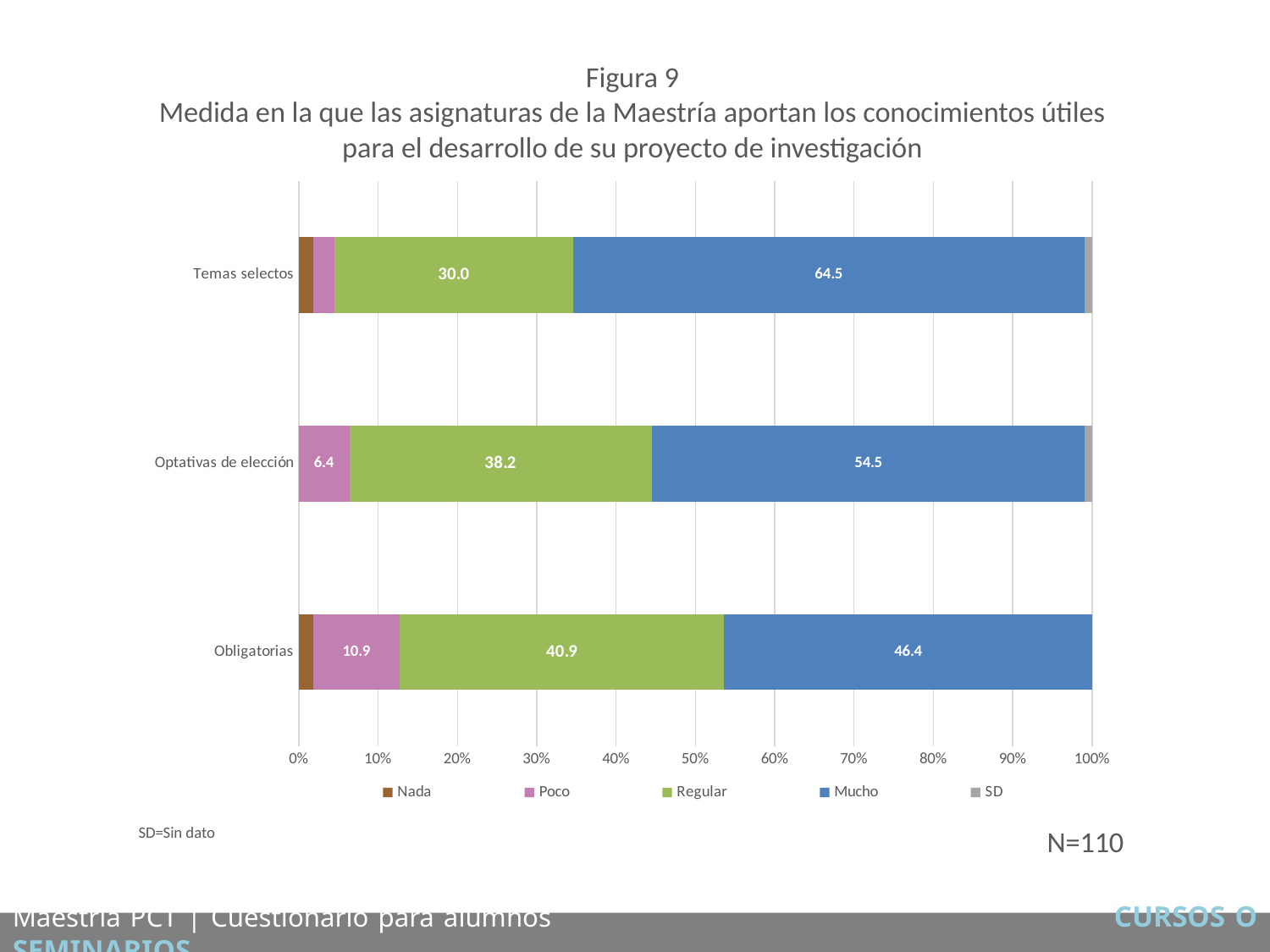
How many categories are shown on the chart? 3 Which category has the highest value for Mucho? Temas selectos Which is larger, the Poco value for Optativas de elección or the Poco value for Obligatorias? Obligatorias How many series does the legend list? 5 What is the value for Poco in the Obligatorias bar? 10.9 What is the difference between the Mucho values for Temas selectos and Obligatorias? 18.1 Is the Nada value for Obligatorias greater or less than 10%? less Which category has the lowest value for Mucho? Obligatorias What is the value for Regular in the Optativas de elección bar? 38.2 What is the difference between the Regular values for Obligatorias and Temas selectos? 10.9 What kind of chart is shown on the slide? Stacked bar chart What is the value for Mucho in the Temas selectos bar? 64.5